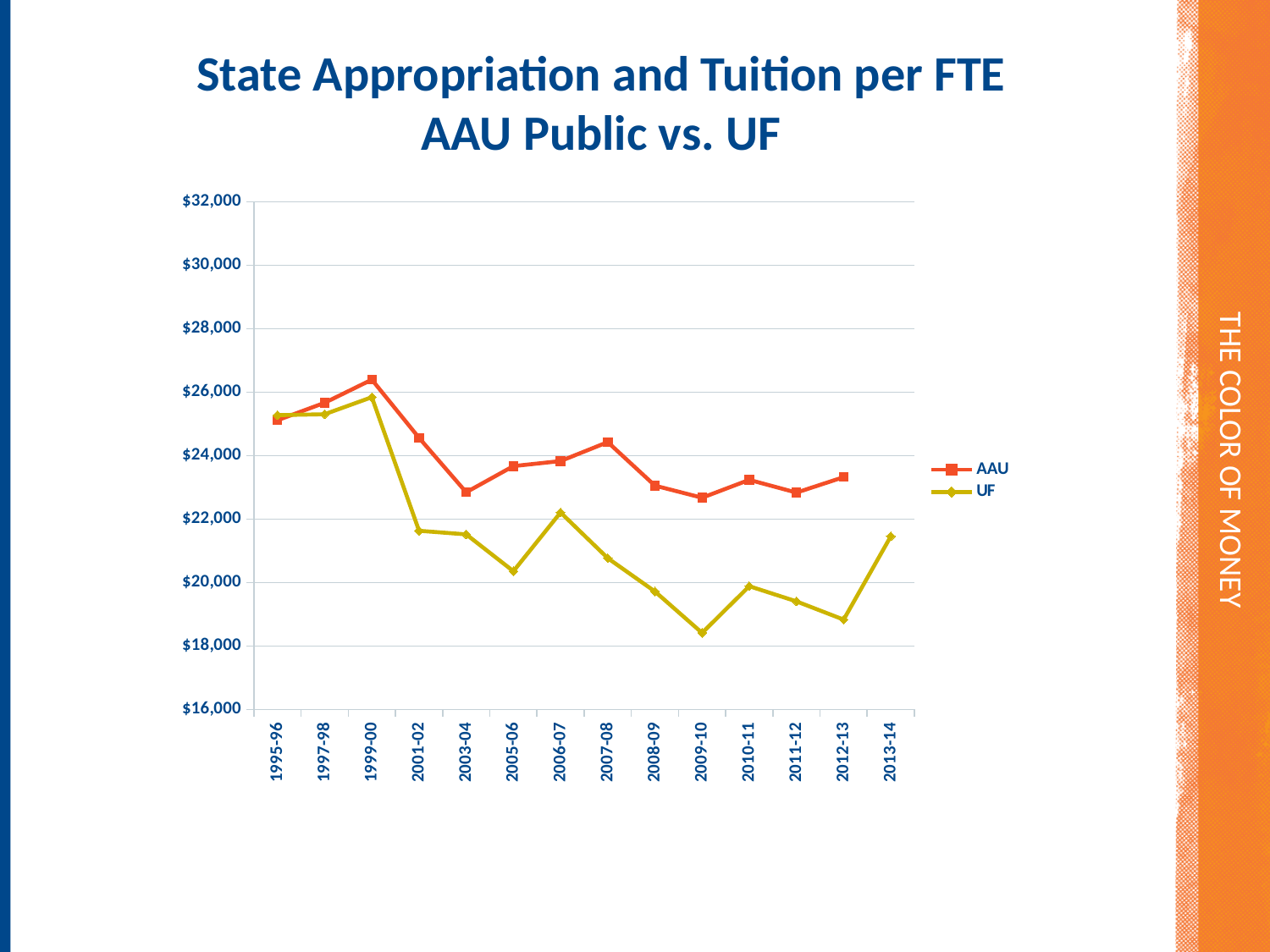
What kind of chart is shown on the slide? line chart In which year is the UF value highest? 1999-00 In which year is the UF value lowest? 2009-10 How many series does the legend list? 2 In which year is the AAU value highest? 1999-00 How many academic years are shown on the x axis? 14 Is the UF value for 2001-02 greater or less than $22,000? less Is the AAU value for 1999-00 greater or less than $26,000? greater Which series is drawn in red with square markers? AAU Which series has the larger value in 2009-10, AAU or UF? AAU Does the UF value rise or fall overall from 1999-00 to 2009-10? fall Is the UF value for 2009-10 greater or less than $20,000? less